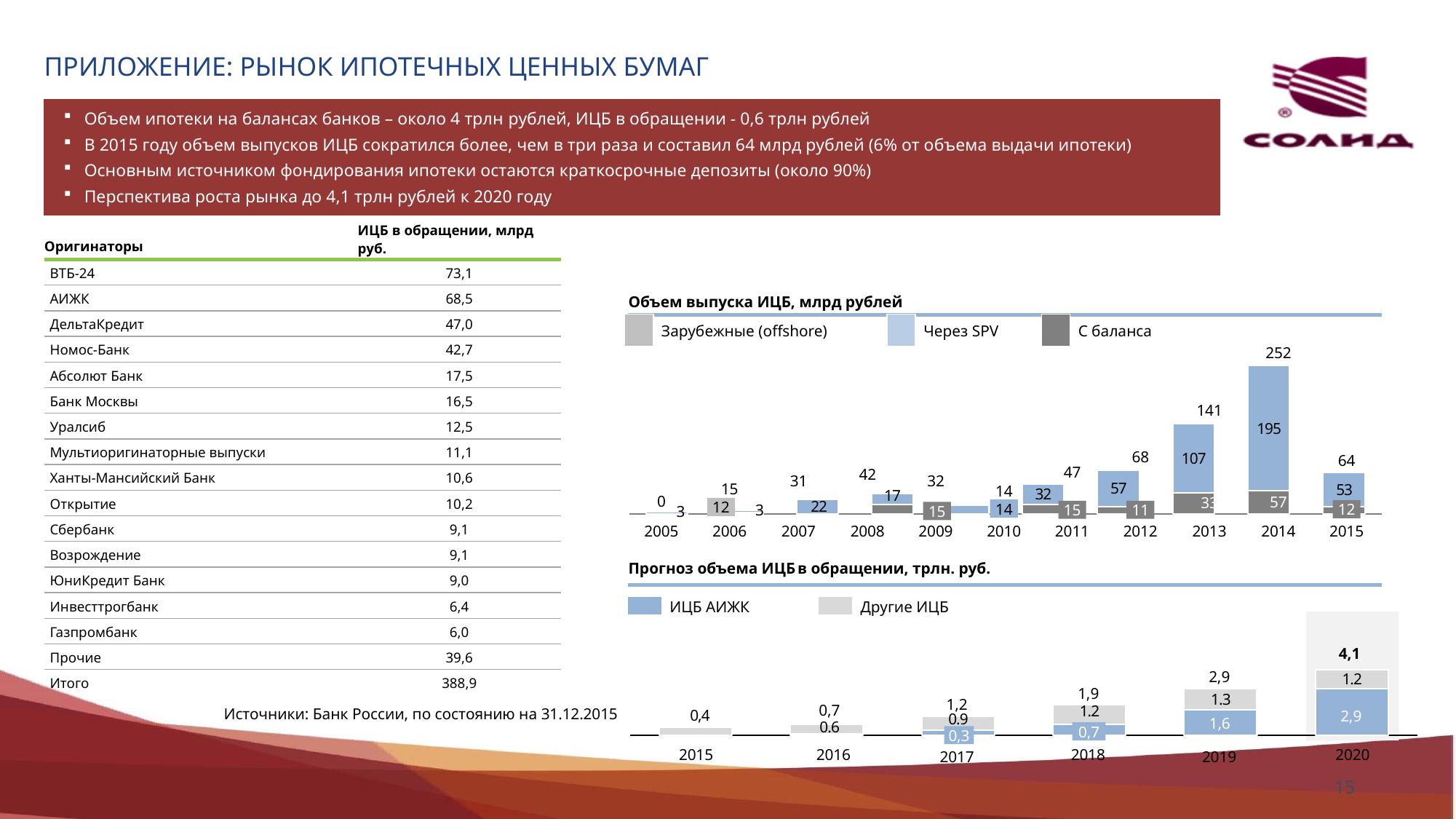
In the chart 'Прогноз объема ИЦБ в обращении, трлн. руб.', which year has the larger total: 2017 or 2018? 2018 In the chart 'Объем выпуска ИЦБ, млрд рублей', what is the difference between the total for 2014 and the total for 2015? 188 In the chart 'Прогноз объема ИЦБ в обращении, трлн. руб.', do the total values rise or fall from 2015 to 2020? Rise In the chart 'Объем выпуска ИЦБ, млрд рублей', what is the total issuance value shown for 2014? 252 In the chart 'Объем выпуска ИЦБ, млрд рублей', what is the 'Через SPV' value for 2013? 107 In the chart 'Прогноз объема ИЦБ в обращении, трлн. руб.', what is the 'ИЦБ АИЖК' value for 2019? 1,6 How many years are shown on the x axis of the chart 'Прогноз объема ИЦБ в обращении, трлн. руб.'? 6 In the chart 'Прогноз объема ИЦБ в обращении, трлн. руб.', what is the total value shown for 2020? 4,1 In the chart 'Объем выпуска ИЦБ, млрд рублей', what is the 'С баланса' value for 2015? 12 What kind of chart is 'Объем выпуска ИЦБ, млрд рублей'? Stacked bar chart In the chart 'Объем выпуска ИЦБ, млрд рублей', which year has the highest total issuance? 2014 How many series does the legend of the chart 'Объем выпуска ИЦБ, млрд рублей' list? 3